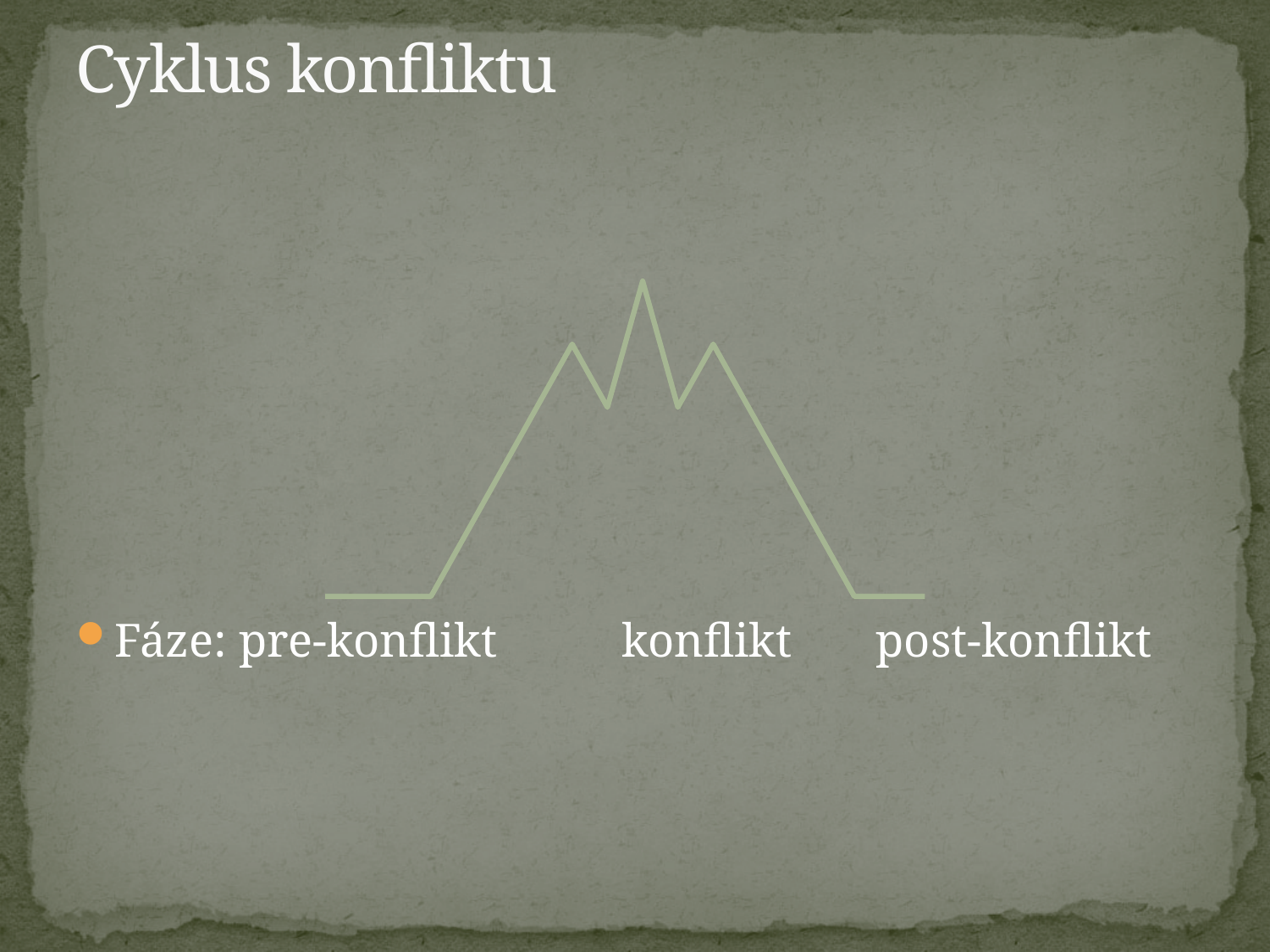
Does the line end at the same level it started at? yes Is the left peak or the middle peak higher? middle Does the line rise or fall from the pre-konflikt phase into the konflikt phase? rise What kind of chart is shown on the slide? line chart Is the line flat or rising at the very start of the pre-konflikt phase? flat What is the title of the slide containing the chart? Cyklus konfliktu Which phase is labelled in the middle, beneath the peaks of the line? konflikt Does the line rise or fall from the konflikt phase into the post-konflikt phase? fall In which phase does the line reach its highest point? konflikt How many peaks does the line have? 3 How many phases are labelled beneath the chart? 3 Which of the three peaks is the highest: the left, the middle, or the right? middle